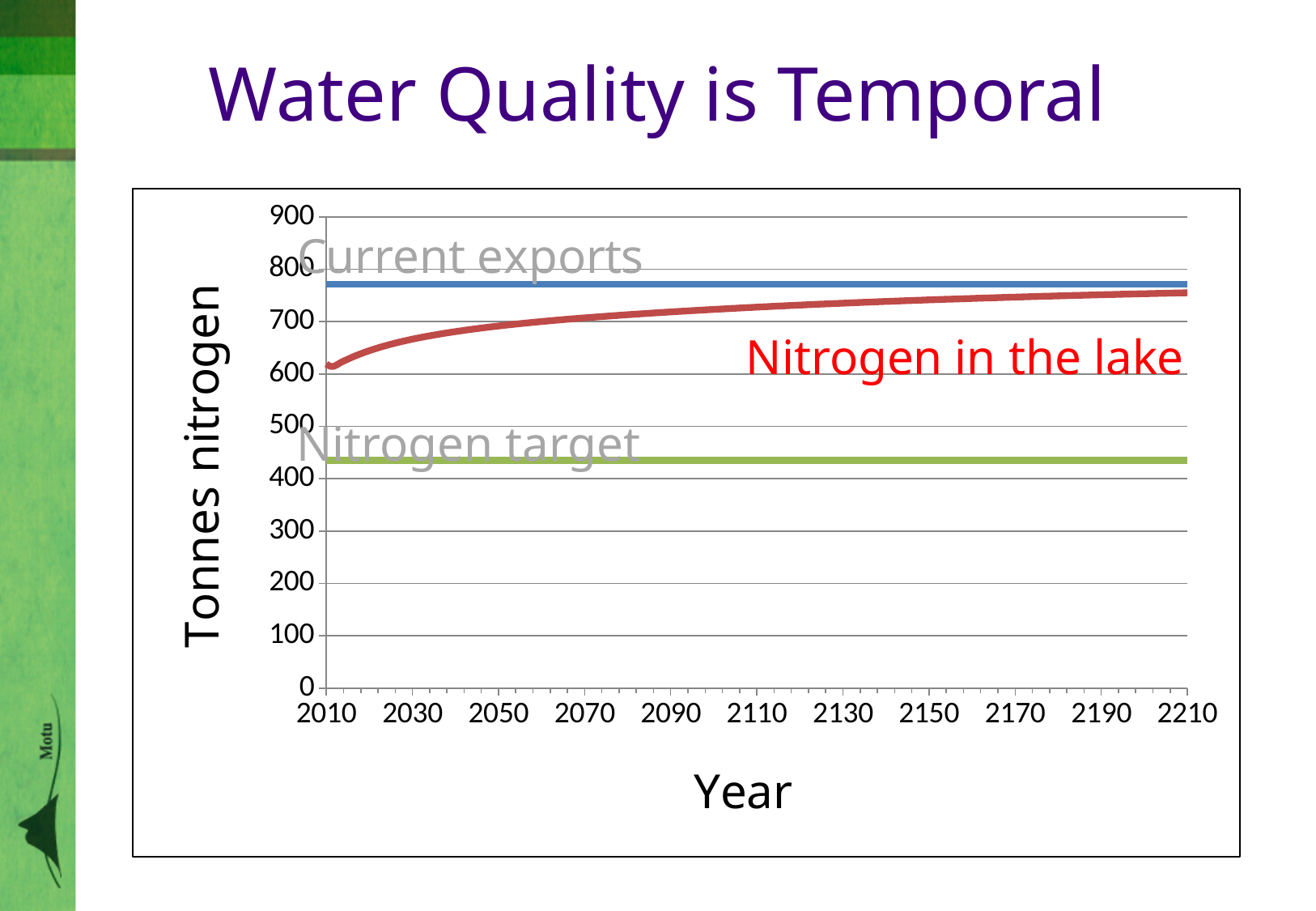
In 2010, which is larger, Nitrogen in the lake or Current exports? Current exports Does the Nitrogen in the lake line rise or fall from 2010 to 2210? Rises Is the value of the Nitrogen target line greater or less than 500? less Which of the three lines is the lowest on the chart? Nitrogen target Is the value of Nitrogen in the lake in 2010 greater or less than 700? less Is the value of the Current exports line greater or less than 700? greater How many lines are plotted on the chart? 3 What is the title of the slide containing the chart? Water Quality is Temporal What kind of chart is shown on the slide? Line chart Which is larger, Current exports or Nitrogen target? Current exports What is the label on the vertical axis of the chart? Tonnes nitrogen Which of the three lines is the highest on the chart? Current exports